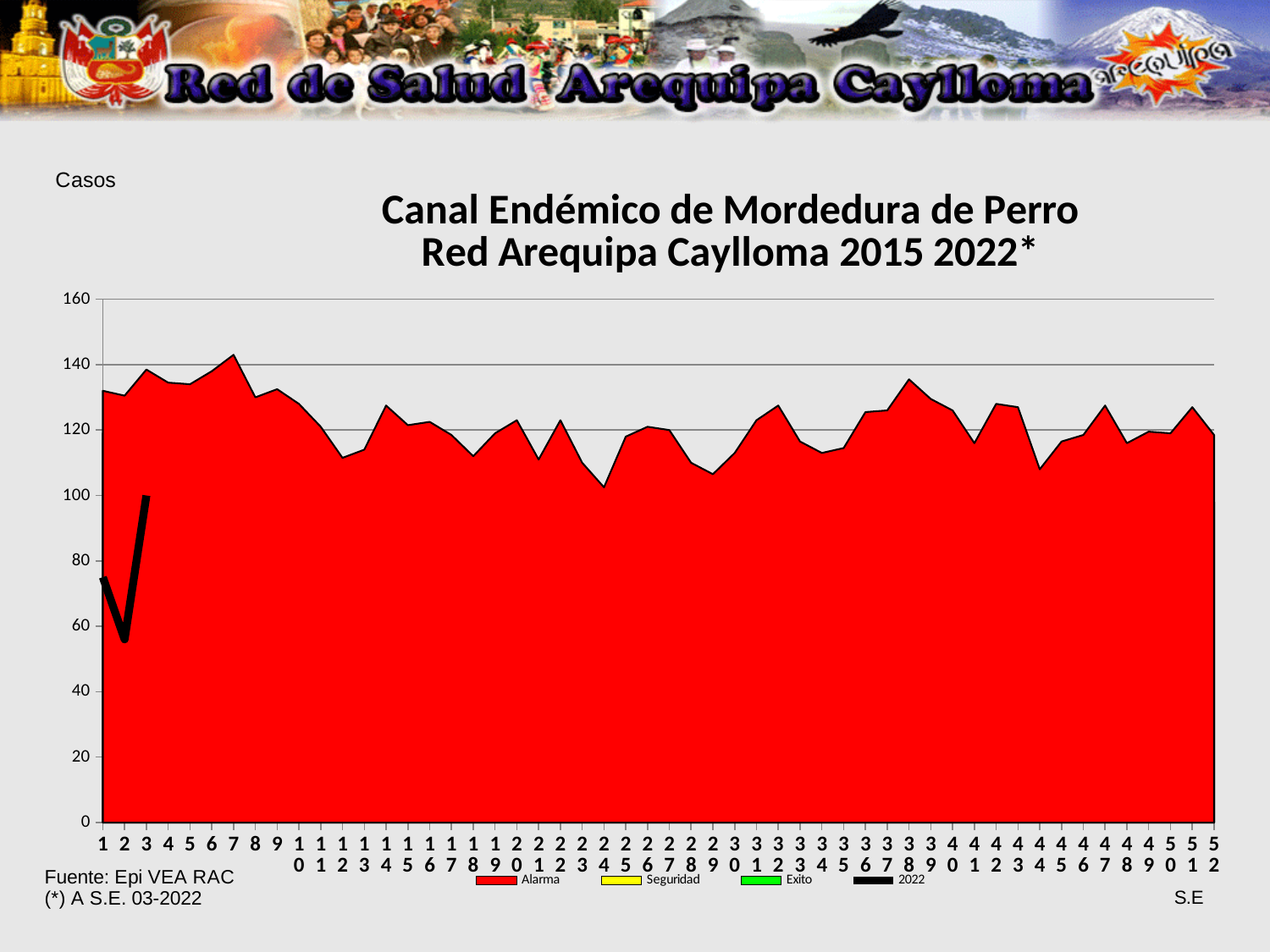
What is the title of the chart? Canal Endémico de Mordedura de Perro Red Arequipa Caylloma 2015 2022* Is the 2022 value at week 3 greater or less than 80? greater Does the 2022 line rise or fall from week 2 to week 3? rise At which week does the Alarma series reach its highest value? 7 Which legend entry is shown in red? Alarma How many epidemiological weeks (S.E.) are shown along the x axis? 52 Is the 2022 value at week 2 greater or less than 80? less What kind of chart is shown on the slide? combination area and line chart Is the Alarma value at week 24 greater or less than 120? less Which is larger, the Alarma value at week 7 or at week 24? week 7 How many series does the legend list? 4